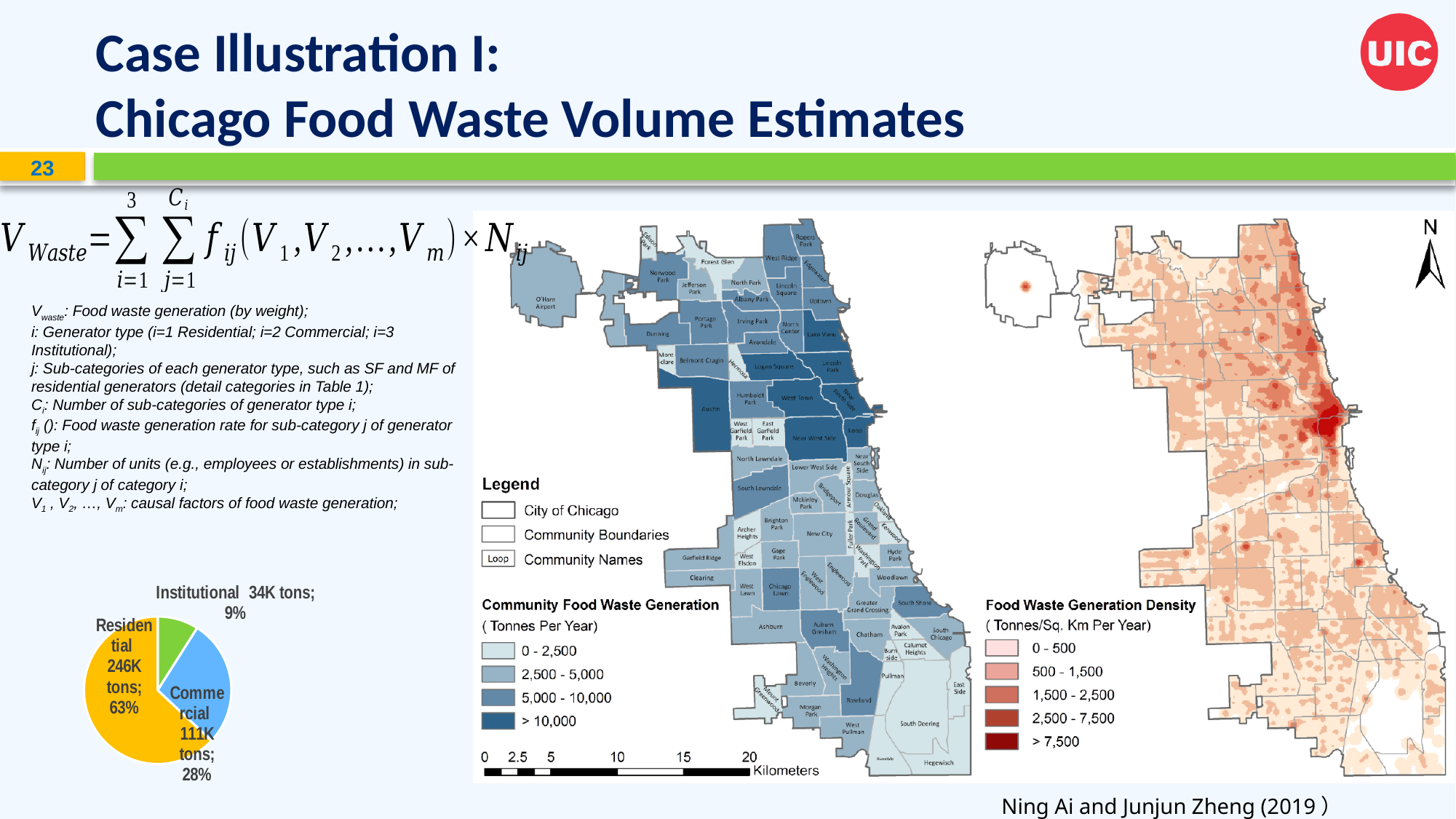
In the pie chart, what share of food waste comes from Residential generators? 63% In the pie chart, what is the combined share of Commercial and Institutional food waste? 37% In the pie chart, how many tons of food waste are attributed to Residential generators? 246K tons In the pie chart, what is the difference in tons between Residential and Commercial food waste? 135K tons In the pie chart, what colour is the Residential slice? Yellow In the pie chart, which is larger: Commercial or Institutional food waste? Commercial In the pie chart, which generator type accounts for the smallest share of food waste? Institutional What kind of chart is shown at the bottom left of the slide? Pie chart In the pie chart, how many slices (generator types) are shown? 3 In the pie chart, which generator type accounts for the largest share of food waste? Residential In the pie chart, how many tons of food waste are attributed to Institutional generators? 34K tons In the pie chart, what share of food waste comes from Commercial generators? 28%